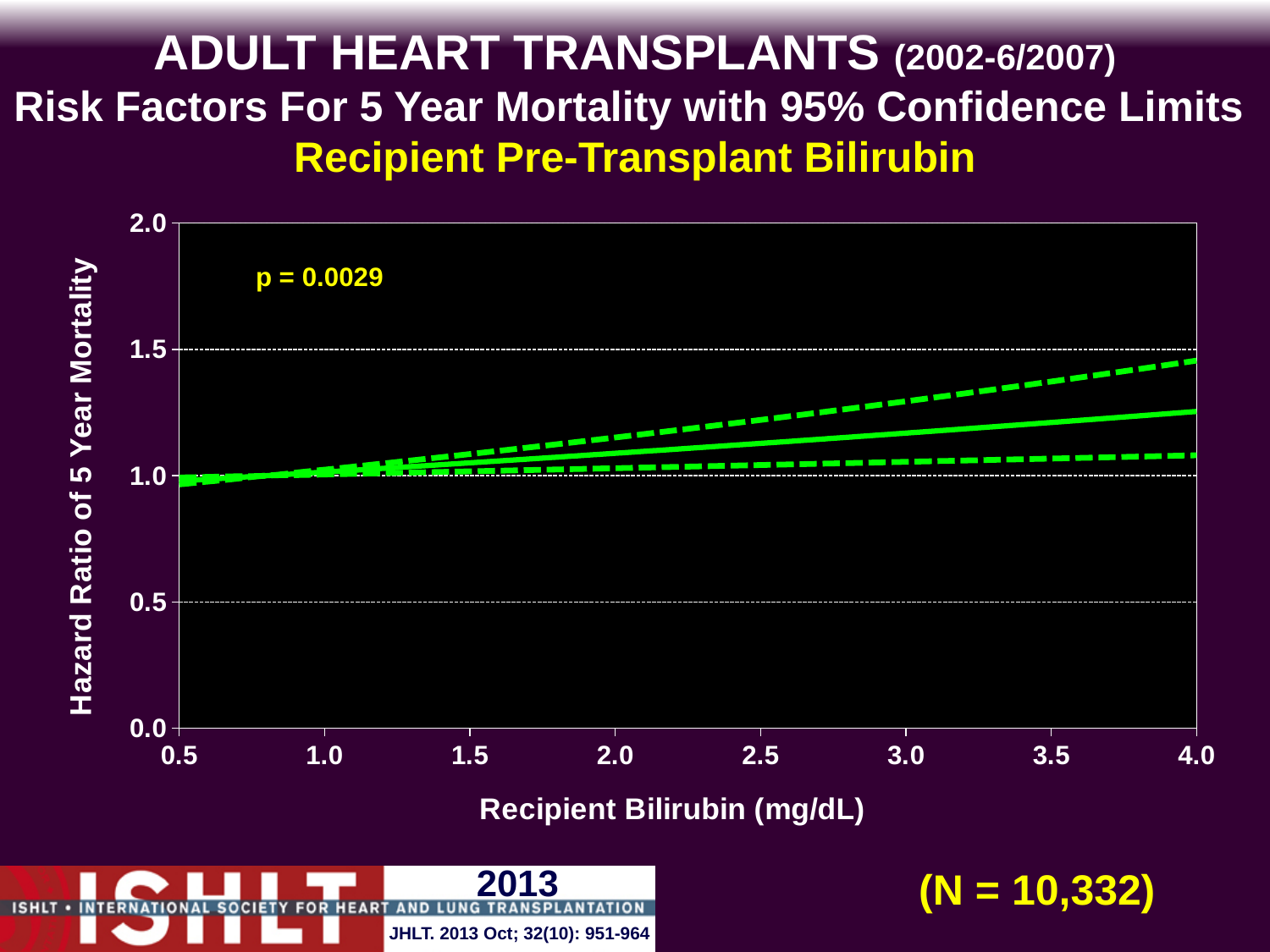
Is the upper 95% confidence limit (upper dashed line) at a recipient bilirubin of 3.0 mg/dL greater or less than 1.5? less Is the hazard ratio (solid line) at a recipient bilirubin of 4.0 mg/dL greater or less than 1.0? greater What is the highest value labelled on the y axis of the chart? 2.0 Is the hazard ratio (solid line) at a recipient bilirubin of 4.0 mg/dL greater or less than 1.5? less How many lines are plotted on the chart? 3 How many tick labels are shown on the x axis of the chart? 8 What is the lowest value labelled on the x axis of the chart? 0.5 What kind of chart is shown on the slide? line chart What p-value is shown on the chart? p = 0.0029 What is the sample size (N) shown on the slide? N = 10,332 Does the hazard ratio of 5 year mortality rise or fall as recipient bilirubin increases from 0.5 to 4.0 mg/dL? rise